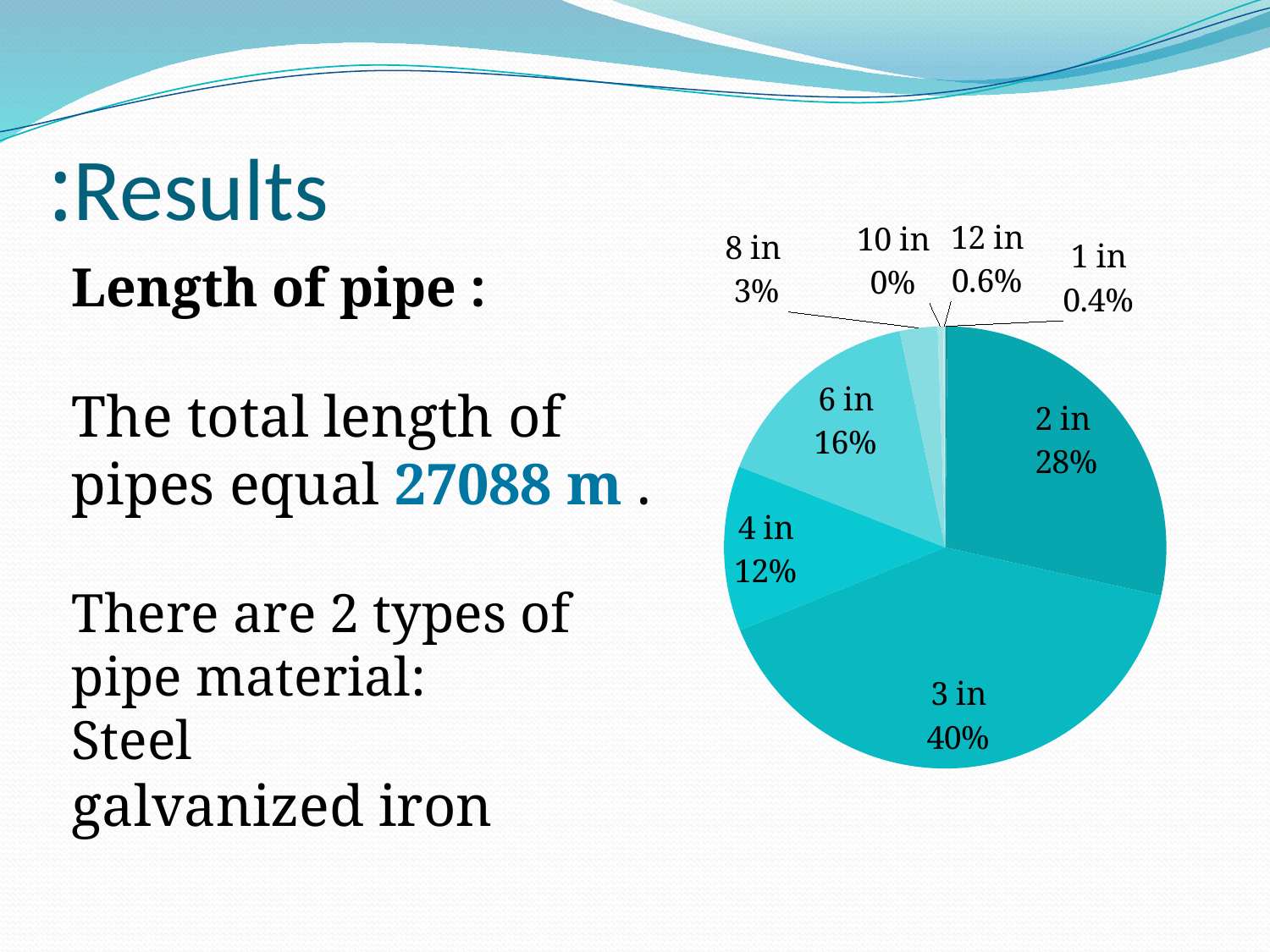
What share of the pie does the 1 in slice have? 0.4% What share of the pie does the 3 in slice have? 40% What share of the pie does the 2 in slice have? 28% What share of the pie does the 4 in slice have? 12% Which slice is larger, 6 in or 4 in? 6 in What share of the pie does the 12 in slice have? 0.6% How many slices does the pie chart have? 8 What is the difference in percentage points between the 3 in and 2 in slices? 12 What share of the pie does the 6 in slice have? 16% What kind of chart is shown on the slide? pie chart Which pipe size has the largest share of the pie? 3 in